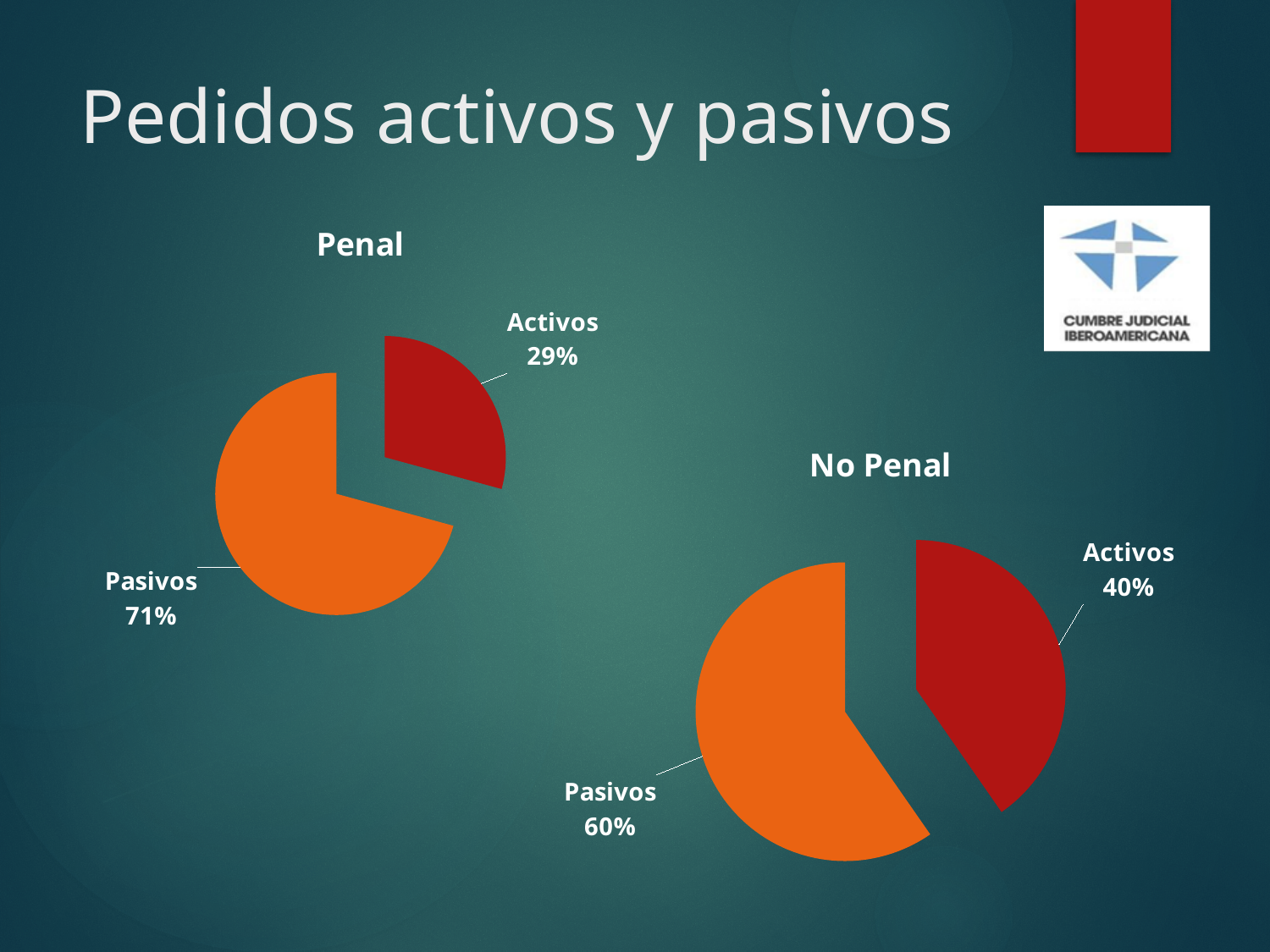
In the Penal chart, what share is Activos? 29% What kind of chart is the Penal chart? Pie chart In the No Penal chart, which slice is the smallest? Activos Is the Activos share larger in the Penal chart or the No Penal chart? No Penal In the No Penal chart, what share is Activos? 40% In the Penal chart, what is the difference between the Pasivos and Activos shares? 42% In the No Penal chart, what share is Pasivos? 60% In the No Penal chart, what colour is the Pasivos slice? Orange In the Penal chart, which slice is the largest? Pasivos In the Penal chart, what share is Pasivos? 71% How many slices does the No Penal chart have? 2 In the No Penal chart, what is the difference between the Pasivos and Activos shares? 20%